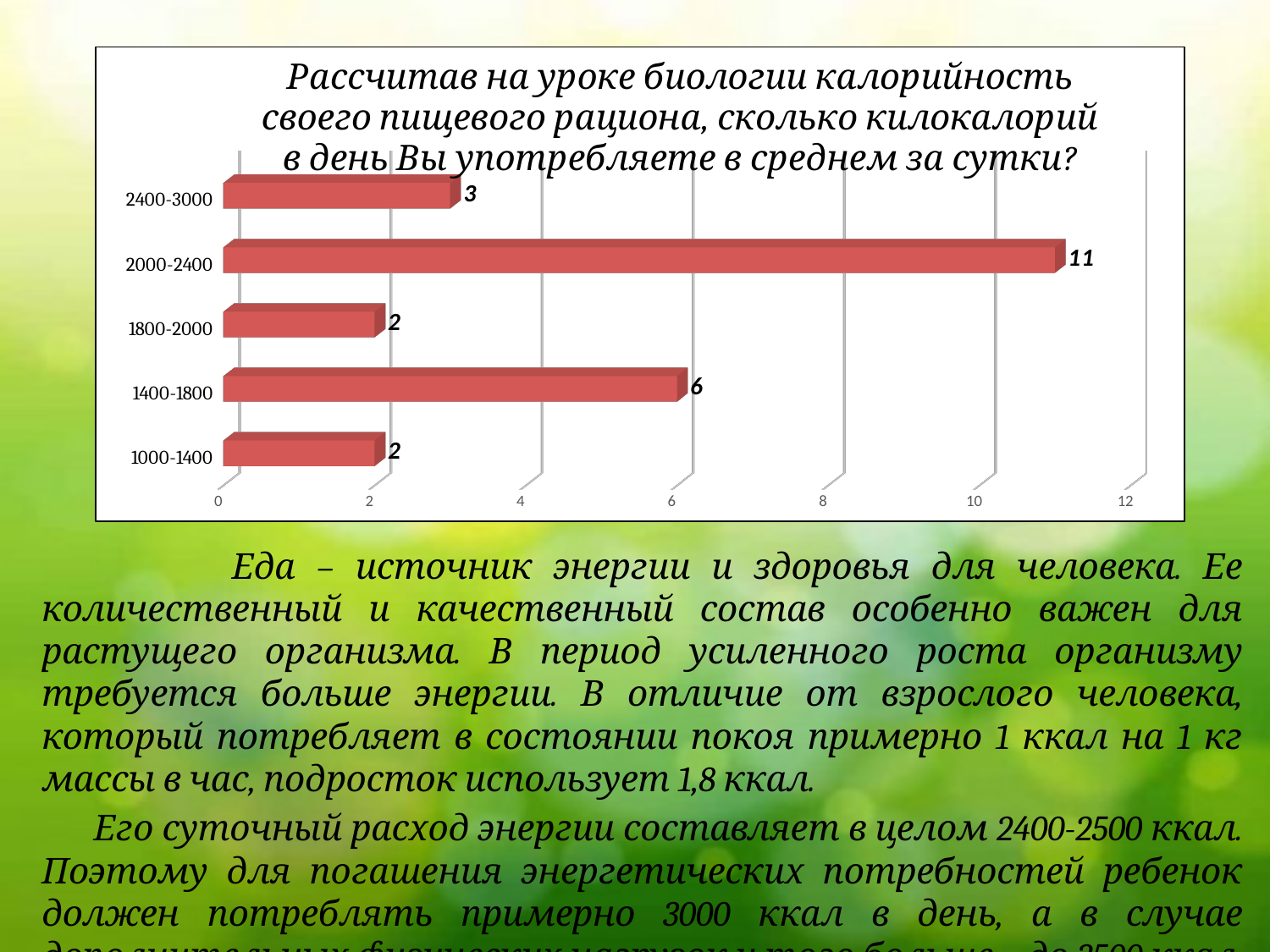
What is the value for the 2000-2400 category? 11 What is the maximum value shown on the horizontal axis? 12 How many categories are shown on the chart? 5 What is the difference between the values for 2000-2400 and 1400-1800? 5 Which category has the highest value? 2000-2400 Which is larger, the value for 2400-3000 or the value for 1800-2000? 2400-3000 What kind of chart is shown on the slide? bar chart Is the value for 2000-2400 greater or less than 10? greater Which two categories share the lowest value? 1800-2000 and 1000-1400 What is the value for the 2400-3000 category? 3 What is the value for the 1400-1800 category? 6 What is the total of all the values shown on the chart? 24